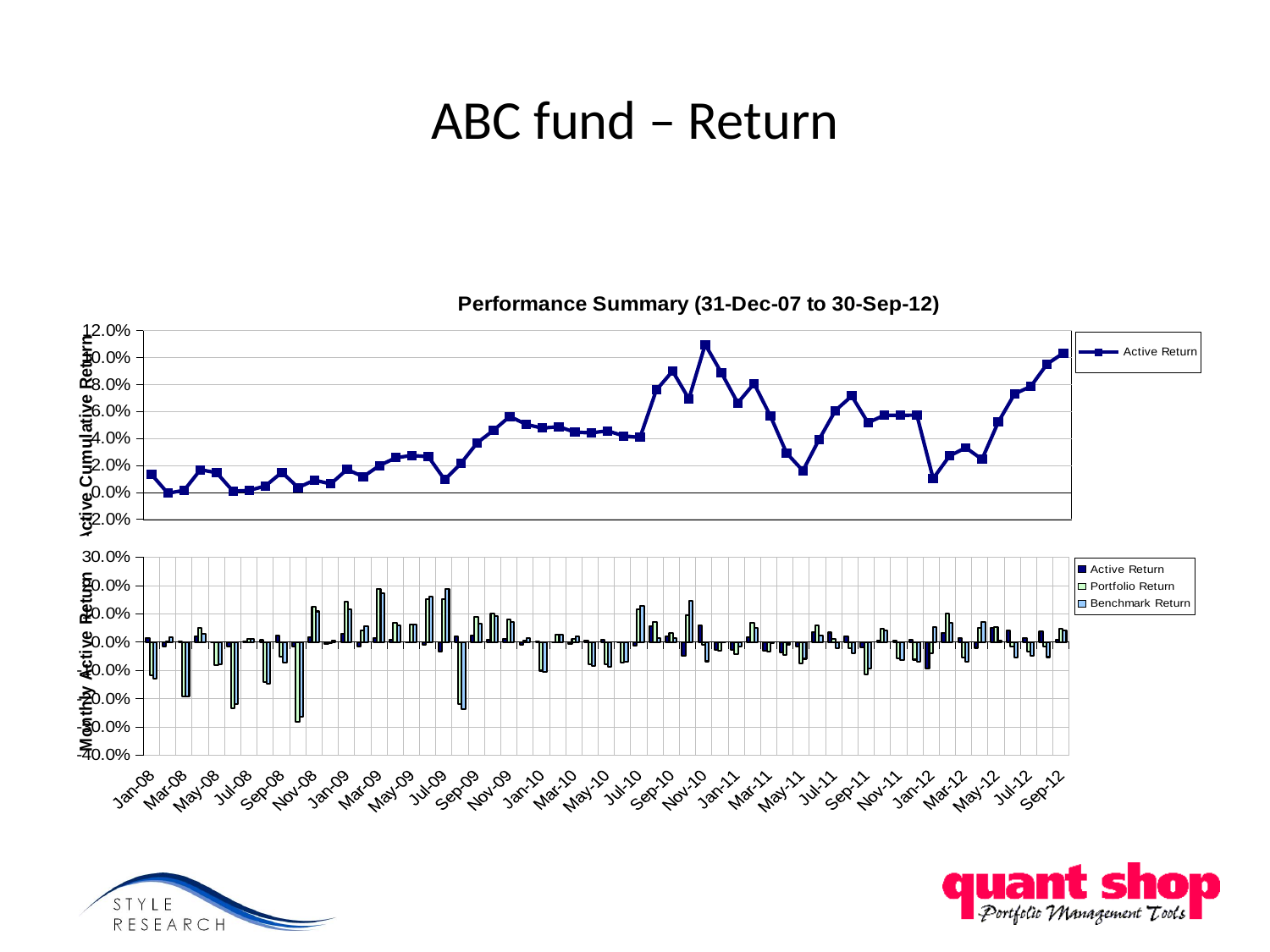
In the bottom chart (Monthly Active Return), how many series does the legend list? 3 In the top chart (Active Cumulative Return), how many series does the legend list? 1 What is the title shown above the charts on the slide? Performance Summary (31-Dec-07 to 30-Sep-12) In the top chart (Active Cumulative Return), what kind of chart is used? line chart In the top chart (Active Cumulative Return), around which month does the Active Return line reach its highest point? Nov-10 In the bottom chart (Monthly Active Return), is the Benchmark Return value for Oct-08 greater or less than -10.0%? less In the top chart (Active Cumulative Return), does the Active Return line overall rise or fall from Jan-08 to Sep-12? rise In the top chart (Active Cumulative Return), is the value for Oct-10 greater or less than 10.0%? less In the top chart (Active Cumulative Return), is the value for Jan-08 greater or less than 2.0%? less In the bottom chart (Monthly Active Return), what kind of chart is used? bar chart In the bottom chart (Monthly Active Return), which series are listed in the legend? Active Return, Portfolio Return, Benchmark Return